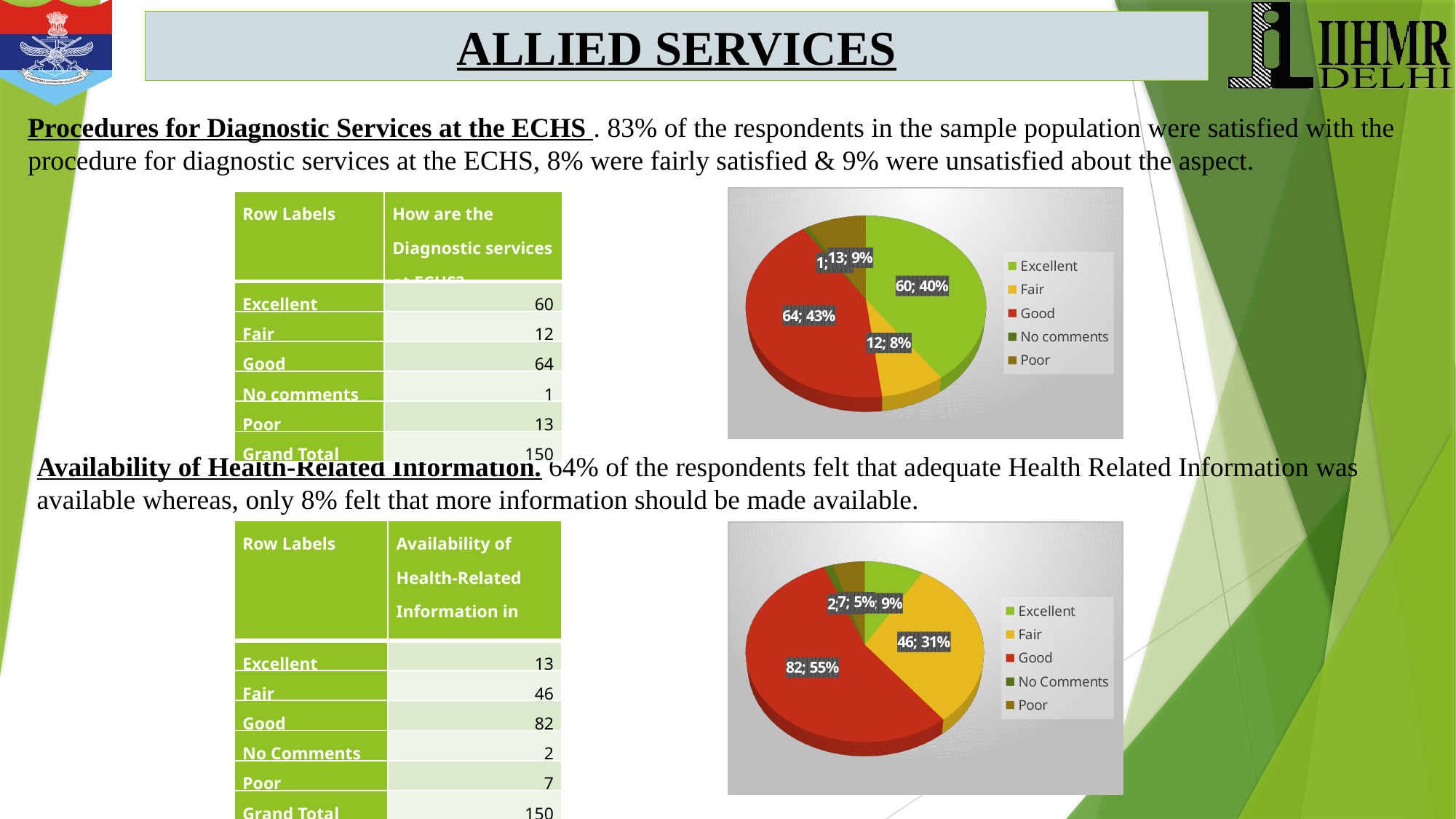
In the top pie chart (Diagnostic services at ECHS), what share of the pie does Excellent represent? 40% In the top pie chart (Diagnostic services at ECHS), what is the difference between the Good count and the Excellent count? 4 In the bottom pie chart (Availability of Health-Related Information), what value is shown for Good? 82; 55% In the top pie chart (Diagnostic services at ECHS), which category has the largest slice? Good In the bottom pie chart (Availability of Health-Related Information), what share of the pie does Fair represent? 31% What type of chart is shown on the top right of the slide? pie chart In the bottom pie chart (Availability of Health-Related Information), which is larger, Fair or Excellent? Fair In the top pie chart (Diagnostic services at ECHS), what value is shown for Good? 64; 43% How many entries does the legend of the top pie chart list? 5 In the bottom pie chart (Availability of Health-Related Information), what is the difference between the Good count and the Fair count? 36 In the bottom pie chart (Availability of Health-Related Information), which category has the largest slice? Good What colour is used for the Good slice in both pie charts? red